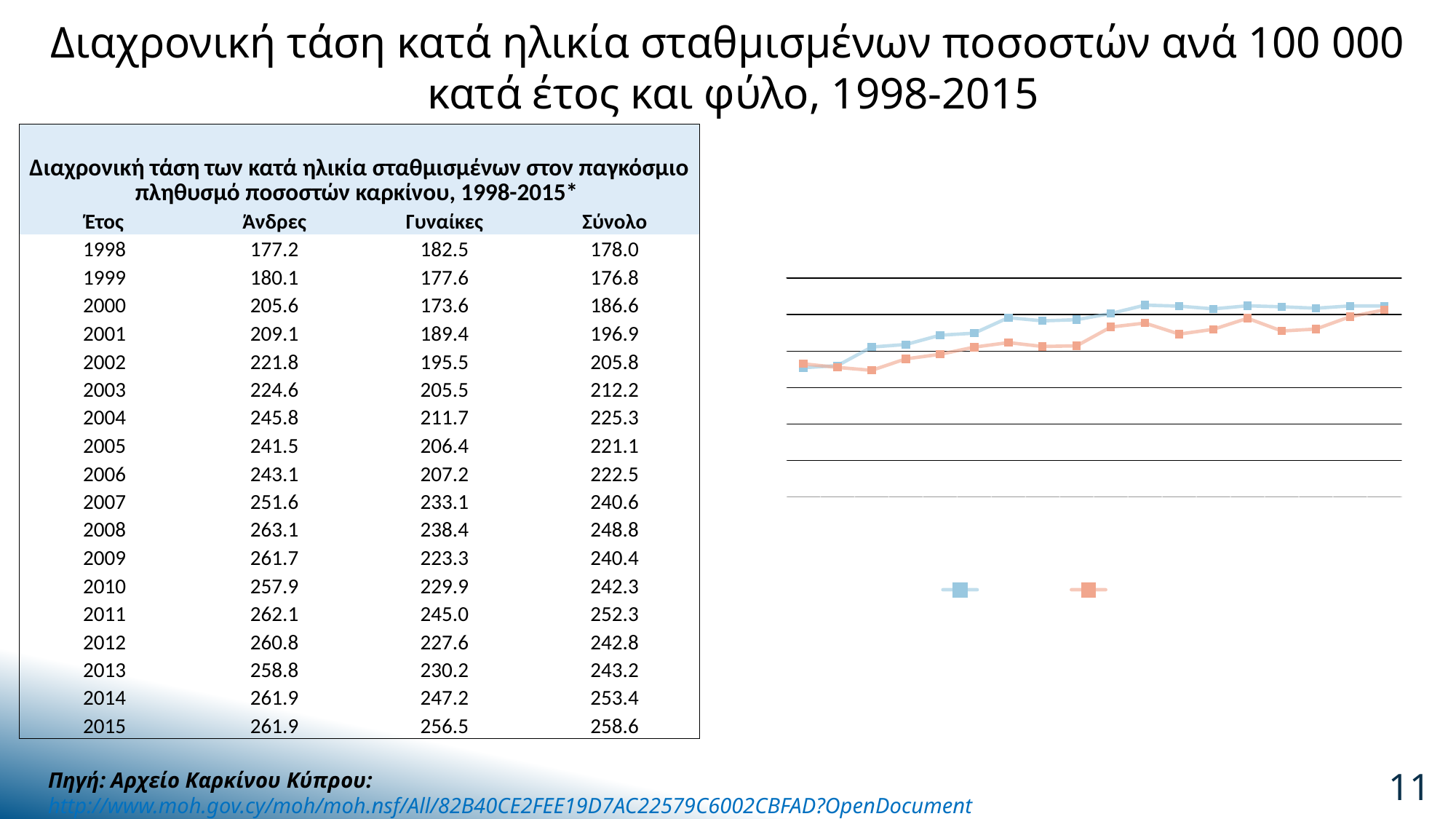
Do the values of the orange line generally rise or fall from left to right along the x axis? rise Do the values of the blue line generally rise or fall from left to right along the x axis? rise What colours are the two lines in the chart? blue and orange What kind of chart is shown on the right side of the slide? line chart What marker shape is used on the lines in the chart? square In the middle section of the chart, which line is higher, the blue one or the orange one? blue How many series does the legend of the chart list? 2 How many data points does each line in the chart have? 18